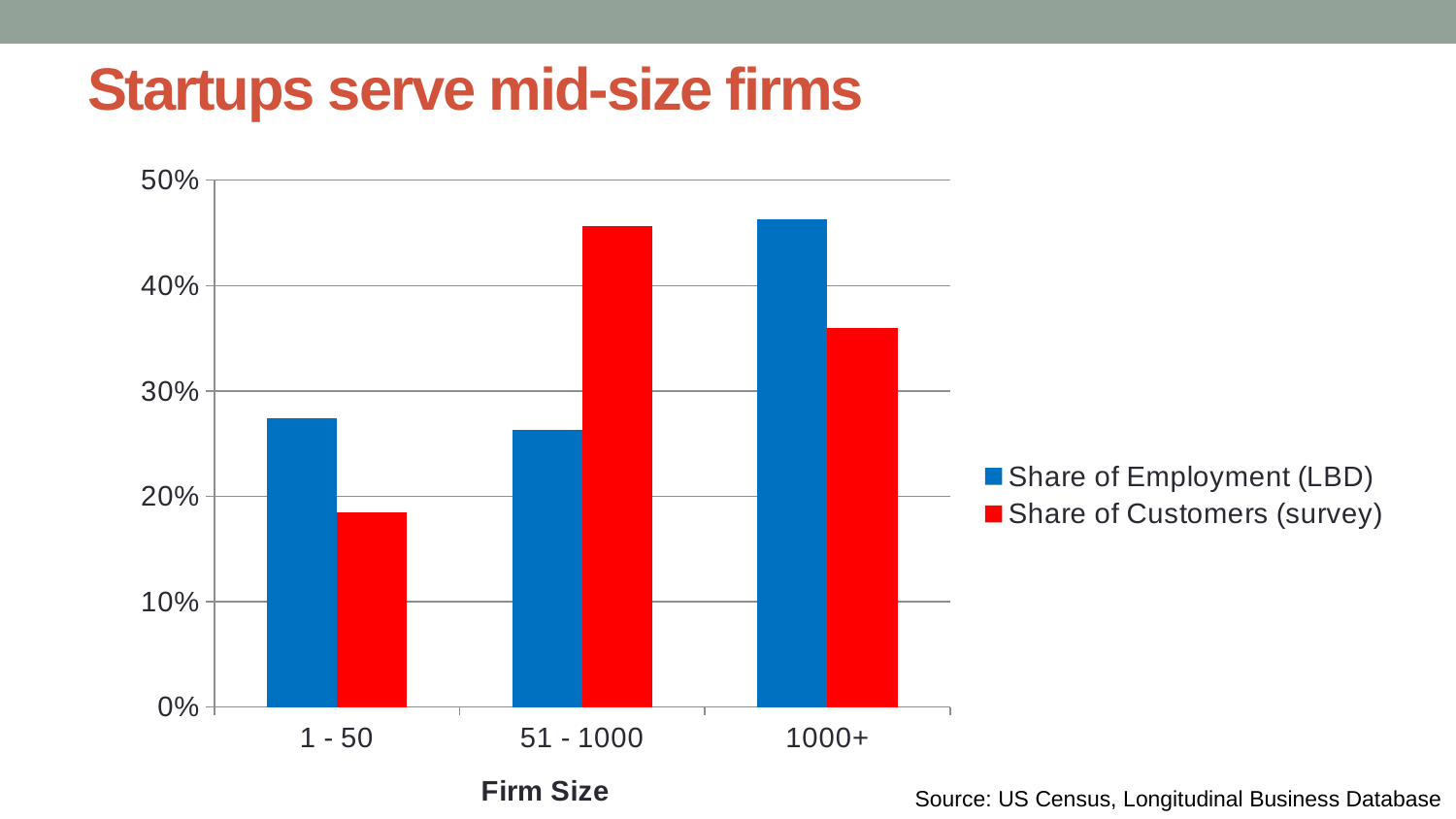
What kind of chart is shown on the slide? Bar chart For firms of size 51 - 1000, which is larger: Share of Employment (LBD) or Share of Customers (survey)? Share of Customers (survey) Is the Share of Customers (survey) for firms of size 1 - 50 greater or less than 20%? less How many series does the legend list? 2 Is the Share of Employment (LBD) for firms of size 1000+ greater or less than 40%? greater What is the title of the slide? Startups serve mid-size firms What colour represents Share of Customers (survey) in the chart? Red Which firm size category has the lowest Share of Customers (survey)? 1 - 50 For firms of size 1000+, which is larger: Share of Employment (LBD) or Share of Customers (survey)? Share of Employment (LBD) Which firm size category has the highest Share of Employment (LBD)? 1000+ How many firm size categories are shown on the x axis? 3 Which firm size category has the highest Share of Customers (survey)? 51 - 1000